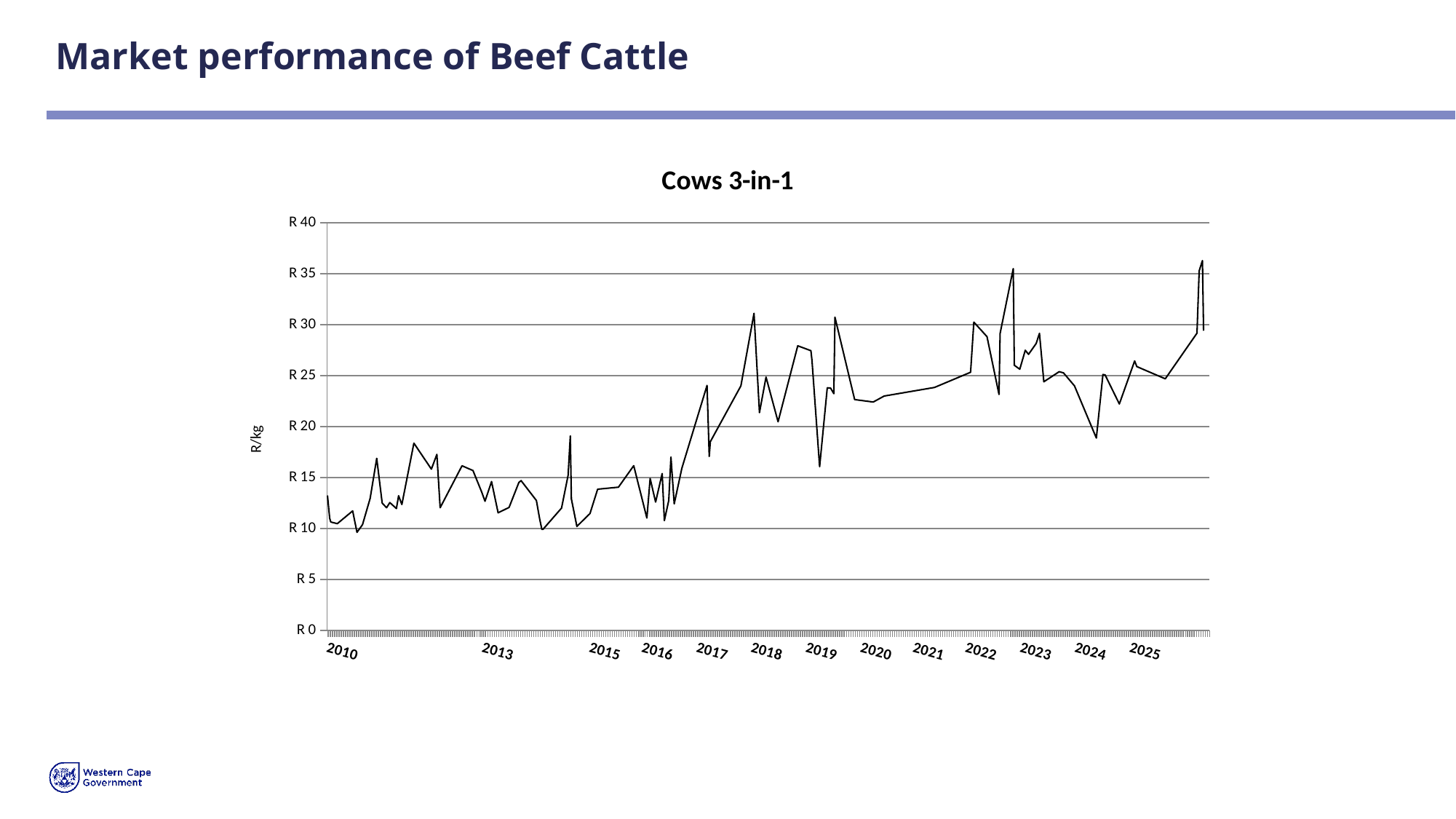
Is the highest value at the end of the series (2025) greater or less than R 30? greater Is the value at the start of 2010 greater or less than R 15? less Overall, do the values rise or fall from 2010 to 2025? rise What kind of chart is shown on the slide? line chart Is the lowest value around 2024 greater or less than R 25? less What is the title of the chart? Cows 3-in-1 What is the label on the vertical axis of the chart? R/kg Which period has higher values: around 2010 or around 2025? around 2025